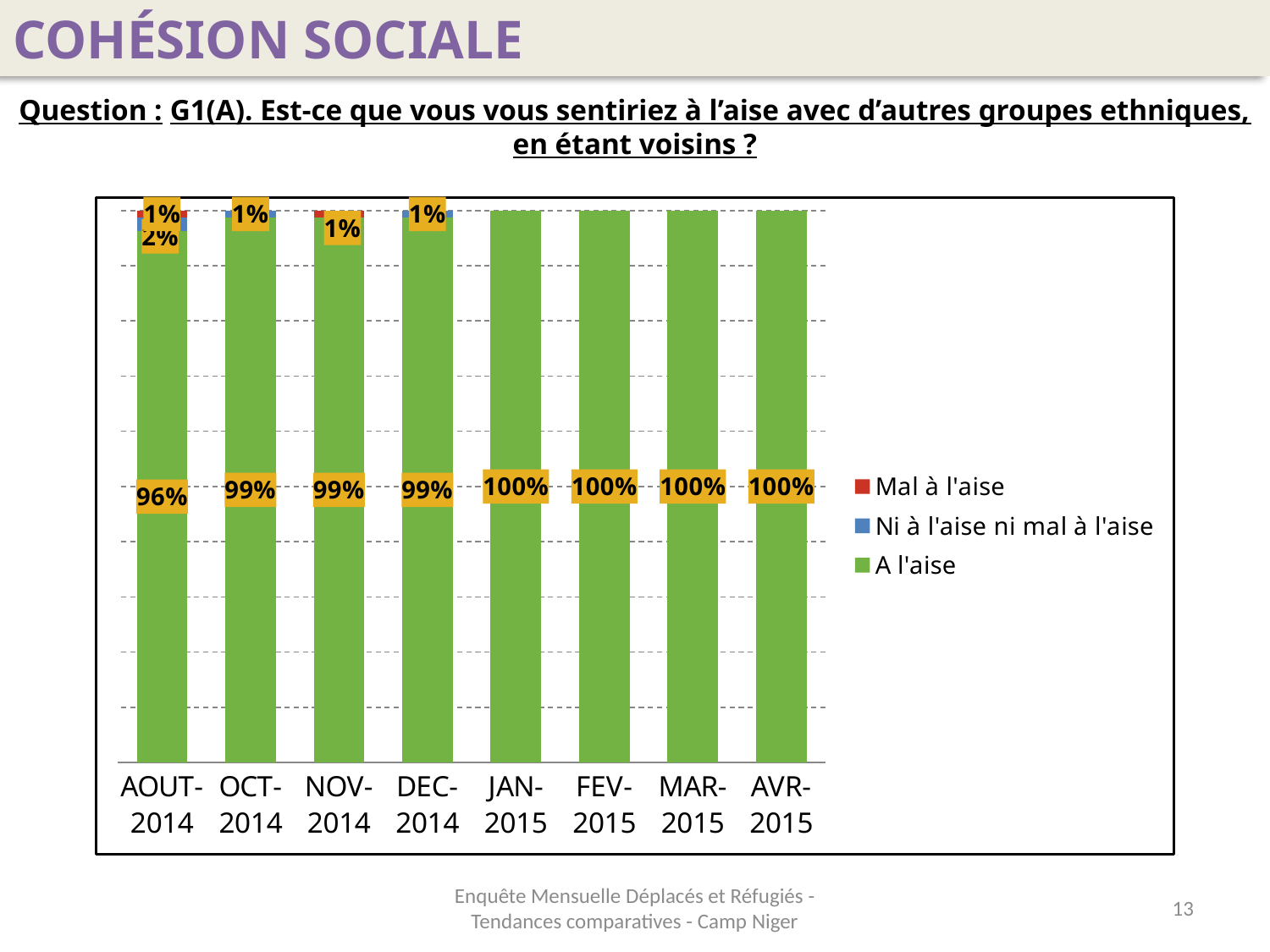
What is the value of 'Ni à l'aise ni mal à l'aise' for AOUT-2014? 2% What is the value of 'A l'aise' for JAN-2015? 100% What is the difference between the 'A l'aise' values for AVR-2015 and AOUT-2014? 4% Which legend entry is shown in green? A l'aise What is the value of 'A l'aise' for OCT-2014? 99% Which month has the lowest value for 'A l'aise'? AOUT-2014 What is the value of 'A l'aise' for AOUT-2014? 96% Does the 'A l'aise' value rise or fall from AOUT-2014 to AVR-2015? rise Which is larger, the 'A l'aise' value for DEC-2014 or for AOUT-2014? DEC-2014 What kind of chart is shown on the slide? stacked bar chart How many months are shown on the x axis? 8 How many series does the legend list? 3